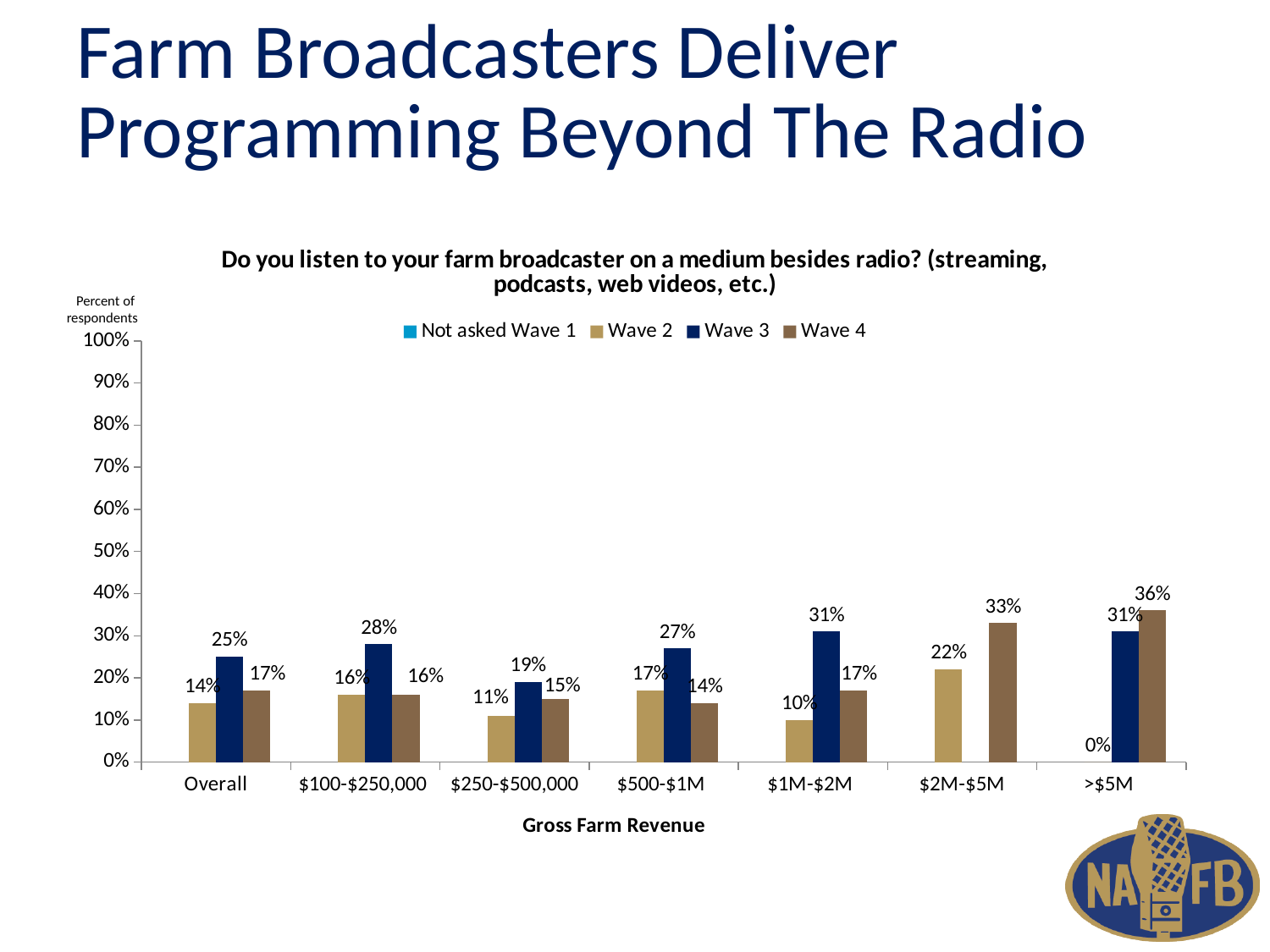
What is the label of the x axis? Gross Farm Revenue What is the Wave 4 value for the $2M-$5M category? 33% What is the Wave 3 value for the Overall category? 25% How many series does the legend list? 4 What is the Wave 2 value for the $1M-$2M category? 10% What is the difference between the Wave 3 and Wave 2 values for the $100-$250,000 category? 12% Which is larger for the $500-$1M category, the Wave 2 value or the Wave 4 value? Wave 2 What is the Wave 2 value for the >$5M category? 0% How many gross farm revenue categories are shown on the x axis? 7 Which category has the highest Wave 4 value? >$5M Which category has the lowest Wave 2 value? >$5M What kind of chart is shown on the slide? Bar chart